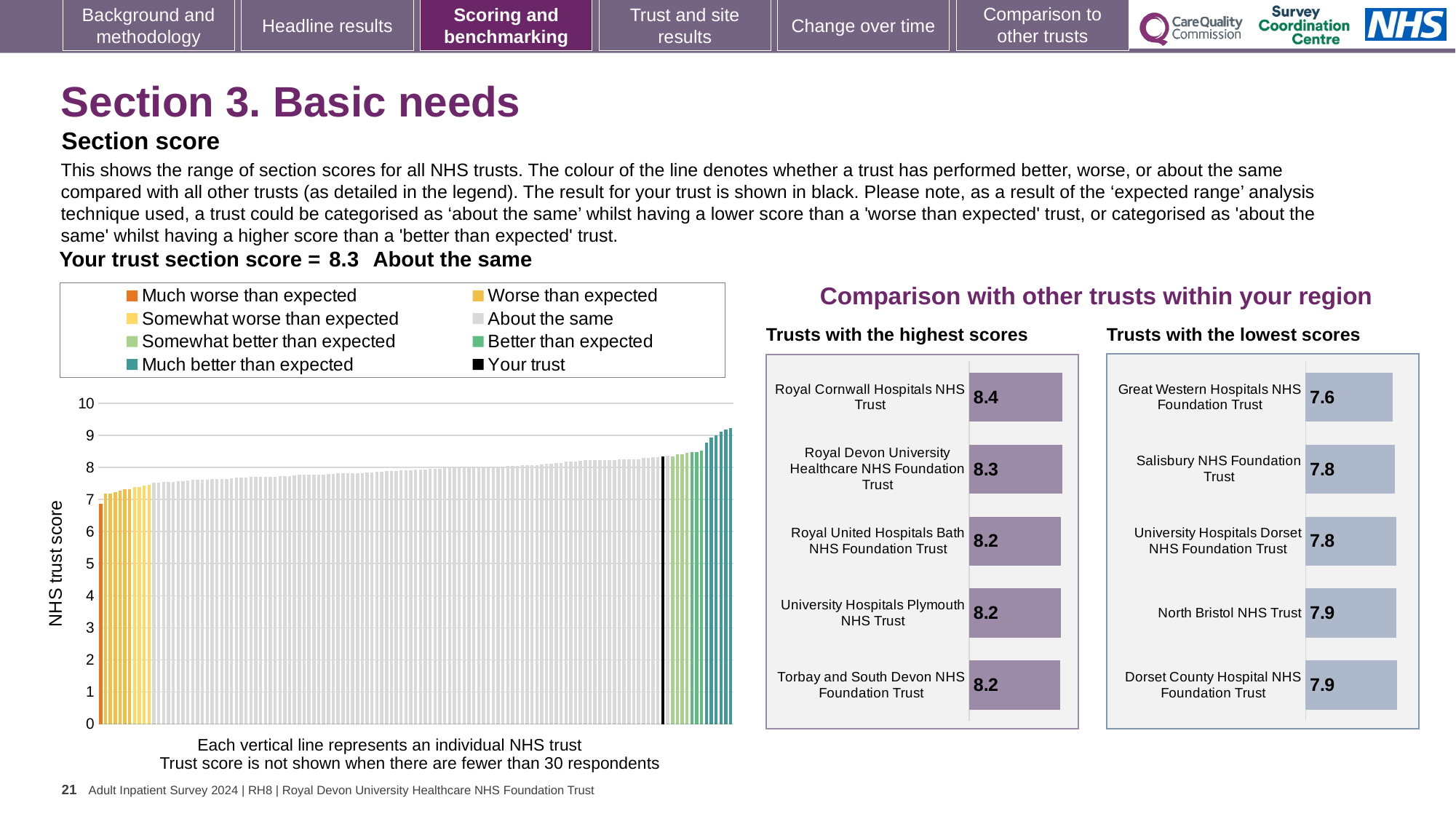
In the 'Trusts with the lowest scores' chart, which has the larger score: Great Western Hospitals NHS Foundation Trust or Salisbury NHS Foundation Trust? Salisbury NHS Foundation Trust How many trusts are listed in the 'Trusts with the lowest scores' chart? 5 In the 'Trusts with the highest scores' chart, what is the difference between the scores of Royal Cornwall Hospitals NHS Trust and Royal Devon University Healthcare NHS Foundation Trust? 0.1 In the 'Trusts with the lowest scores' chart, what is the score for Great Western Hospitals NHS Foundation Trust? 7.6 In the 'Trusts with the lowest scores' chart, what is the score for North Bristol NHS Trust? 7.9 In the 'Trusts with the highest scores' chart, what is the score for Torbay and South Devon NHS Foundation Trust? 8.2 In the main NHS trust score chart, do the values rise or fall from left to right? Rise How many entries does the legend of the main NHS trust score chart list? 8 In the 'Trusts with the lowest scores' chart, which trust has the lowest score? Great Western Hospitals NHS Foundation Trust What kind of chart is the main chart showing the range of section scores for all NHS trusts? Bar chart In the 'Trusts with the highest scores' chart, what is the score for Royal Cornwall Hospitals NHS Trust? 8.4 In the 'Trusts with the highest scores' chart, which trust has the highest score? Royal Cornwall Hospitals NHS Trust